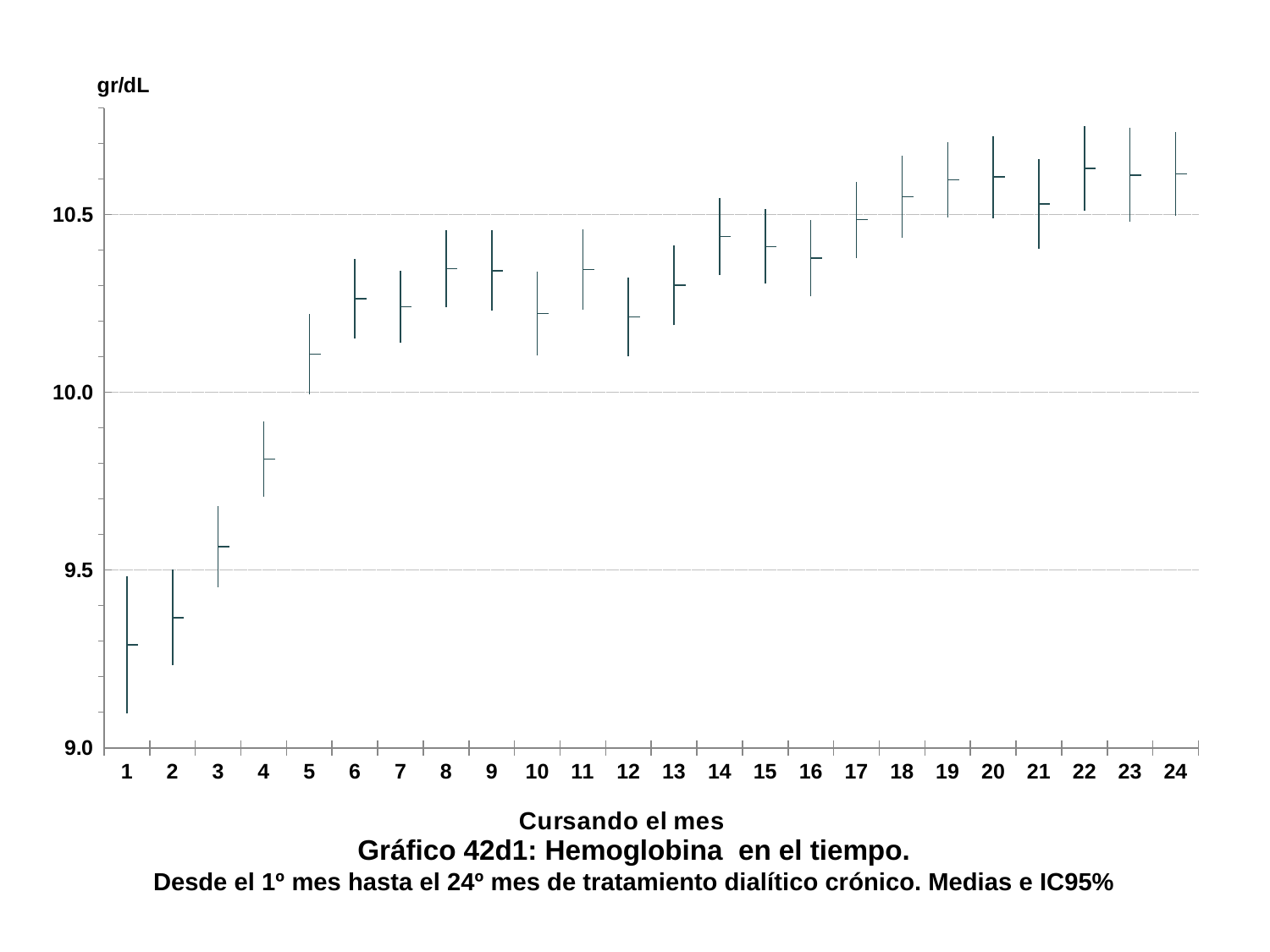
Is the mean value for month 12 greater or less than 10.5? less Is the mean value for month 22 greater or less than 10.5? greater Is the mean value for month 20 greater or less than 10.5? greater Do the mean hemoglobin values generally rise or fall from month 1 to month 24? rise What unit is shown on the y axis? gr/dL What is the title of the x axis? Cursando el mes How many months are plotted on the x axis? 24 Which month has the lowest mean hemoglobin value? 1